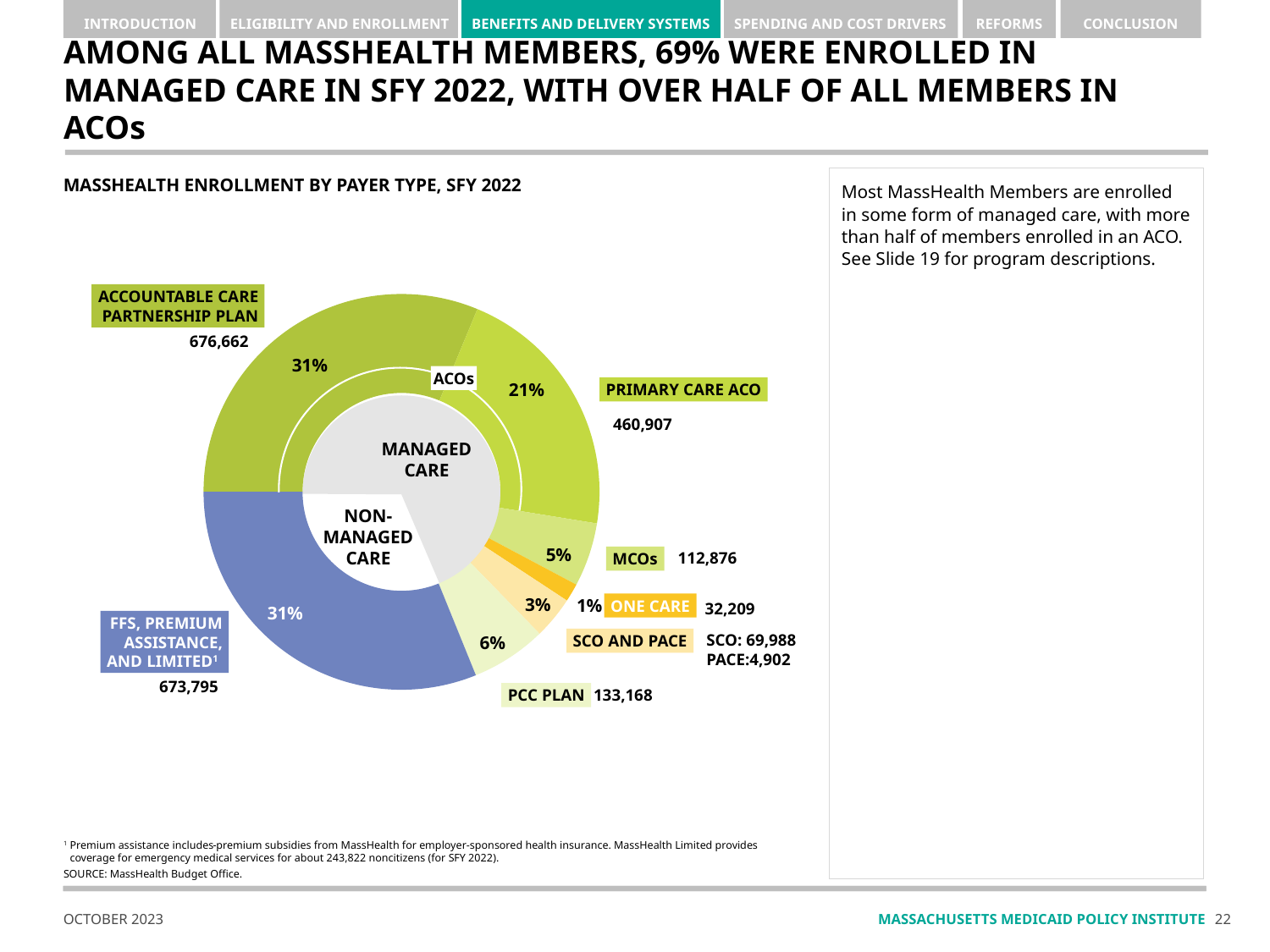
How many members are enrolled in the Accountable Care Partnership Plan? 676,662 Which has more members, the PCC Plan or MCOs? PCC Plan What is the title of the chart on the slide? MASSHEALTH ENROLLMENT BY PAYER TYPE, SFY 2022 What share of enrollment is in One Care? 1% How many members are enrolled in the Primary Care ACO? 460,907 What kind of chart is shown on the slide? Donut (pie) chart How many members are enrolled in SCO? 69,988 What is the difference in members between the Accountable Care Partnership Plan and the Primary Care ACO? 215,755 Which payer type has the smallest share of enrollment? One Care How many members are enrolled in the PCC Plan? 133,168 What share of enrollment is in the Primary Care ACO? 21% How many members are enrolled in MCOs? 112,876